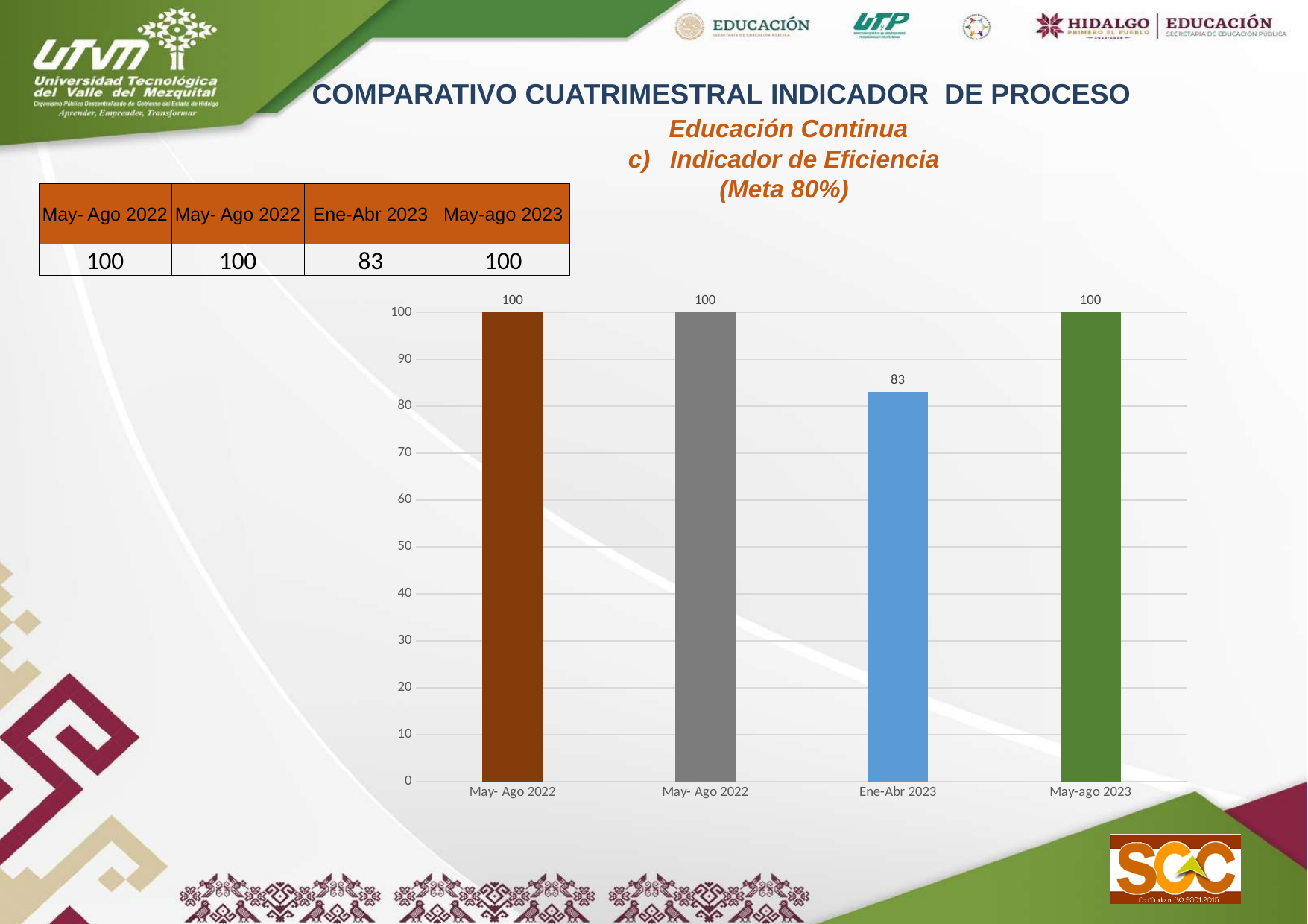
What colour is the bar for Ene-Abr 2023? blue Which category has the lowest value? Ene-Abr 2023 Which is larger, the value for Ene-Abr 2023 or the value for May-ago 2023? May-ago 2023 What is the value for Ene-Abr 2023? 83 Is the value for Ene-Abr 2023 greater or less than 90? less Is the value for Ene-Abr 2023 greater or less than 80? greater What is the value of the first bar on the left (May- Ago 2022)? 100 What is the highest value shown on the vertical axis? 100 How many bars are plotted in the chart? 4 What kind of chart is shown on the slide? bar chart What is the difference between the value for May-ago 2023 and the value for Ene-Abr 2023? 17 What is the value for May-ago 2023? 100